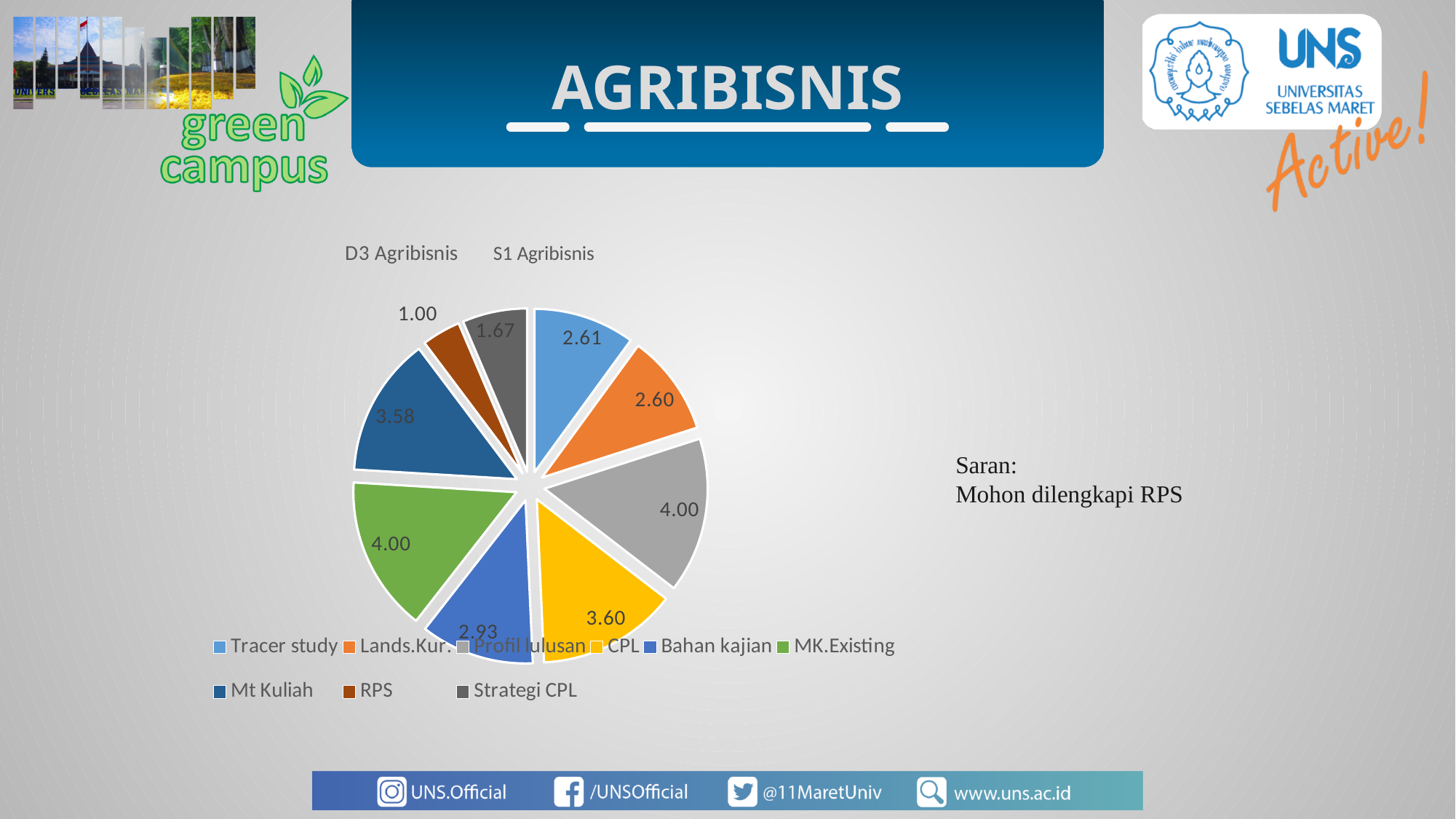
What is the value for Strategi CPL in the pie chart? 1.67 What is the value for Tracer study in the pie chart? 2.61 Which category has the smallest slice in the pie chart? RPS What type of chart is shown on the slide? pie chart How many slices does the pie chart have? 9 What is the value for CPL in the pie chart? 3.60 Which is larger, the value for MK.Existing or the value for Lands.Kur.? MK.Existing Which colour represents RPS in the legend? brown What is the difference between the values for Profil lulusan and RPS? 3.00 What is the value for Bahan kajian in the pie chart? 2.93 What is the difference between the values for CPL and Bahan kajian? 0.67 What is the value for Mt Kuliah in the pie chart? 3.58